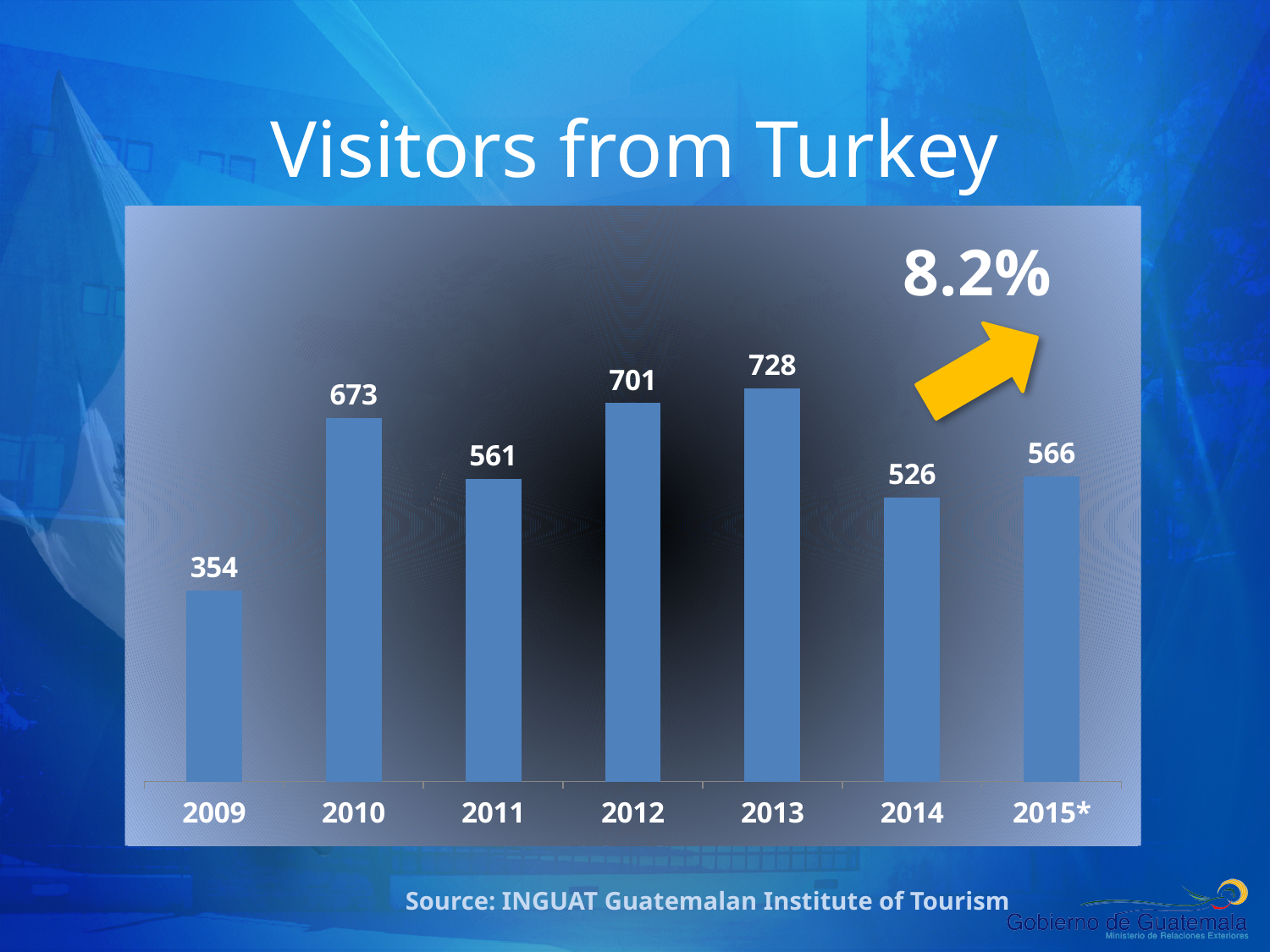
Which year has the lowest number of visitors from Turkey? 2009 What percentage is printed next to the yellow arrow on the chart? 8.2% How many years are shown on the x axis of the chart? 7 What is the value shown for 2013? 728 What kind of chart is shown on the slide? Bar chart Which is larger, the value for 2010 or the value for 2011? 2010 What is the value shown for 2015*? 566 Which year has the highest number of visitors from Turkey? 2013 Did the number of visitors rise or fall from 2014 to 2015*? Rise What is the difference between the values for 2010 and 2009? 319 How many visitors from Turkey were there in 2009? 354 What is the difference between the values for 2013 and 2014? 202